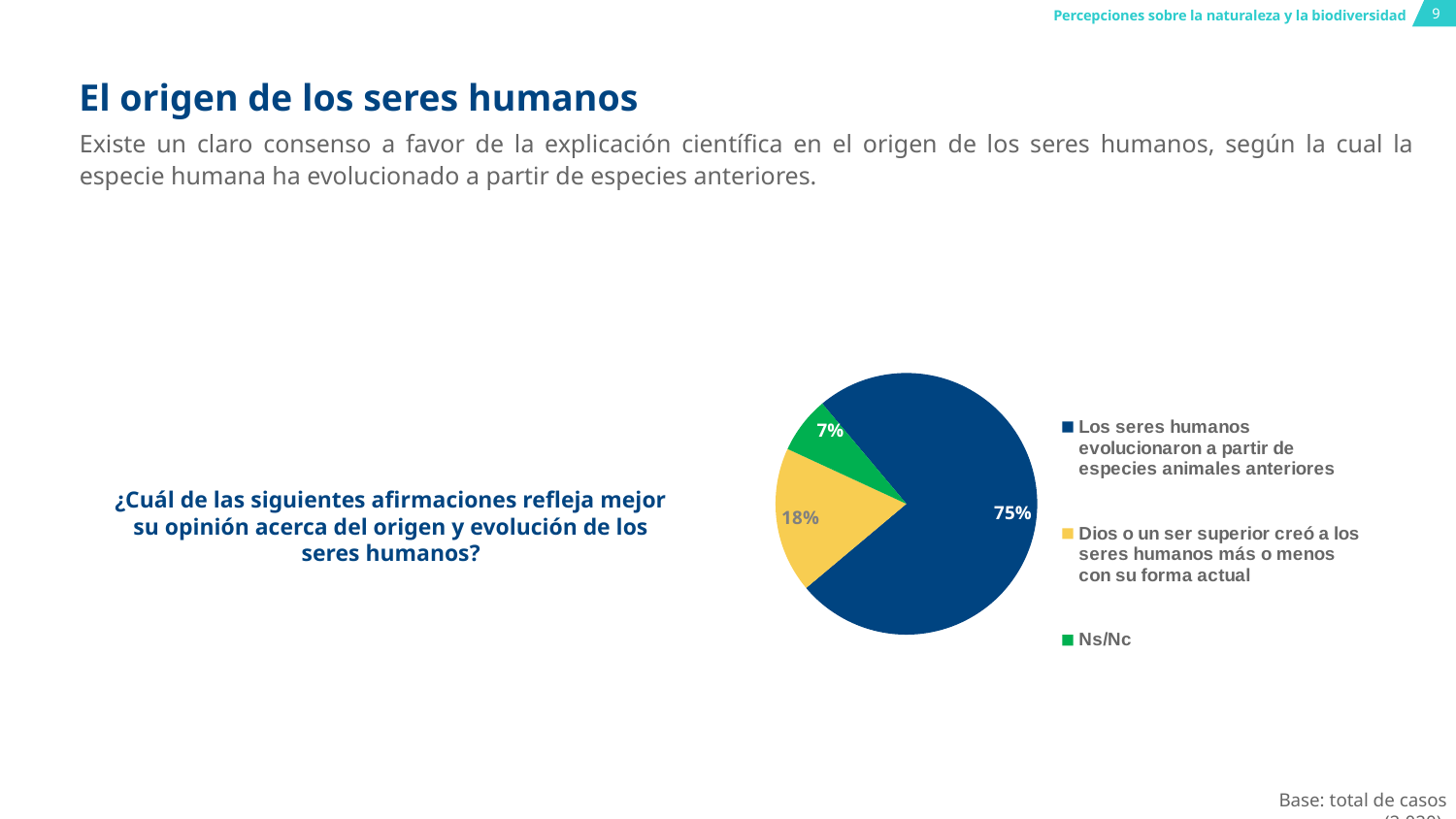
What kind of chart is shown on the slide? pie chart Which category has the largest share of the pie? Los seres humanos evolucionaron a partir de especies animales anteriores What is the difference in percentage points between the 'evolucionaron' slice and the 'Dios o un ser superior' slice? 57 What percentage of respondents chose 'Los seres humanos evolucionaron a partir de especies animales anteriores'? 75% What percentage of respondents chose 'Dios o un ser superior creó a los seres humanos más o menos con su forma actual'? 18% How many slices does the pie chart have? 3 Which category has the smallest share of the pie? Ns/Nc How many entries does the legend list? 3 Which is larger: the share for 'Dios o un ser superior creó a los seres humanos' or the share for 'Ns/Nc'? Dios o un ser superior creó a los seres humanos más o menos con su forma actual What percentage of respondents answered 'Ns/Nc'? 7% What colour is the slice for 'Dios o un ser superior creó a los seres humanos más o menos con su forma actual'? yellow What colour is the slice for 'Ns/Nc'? green